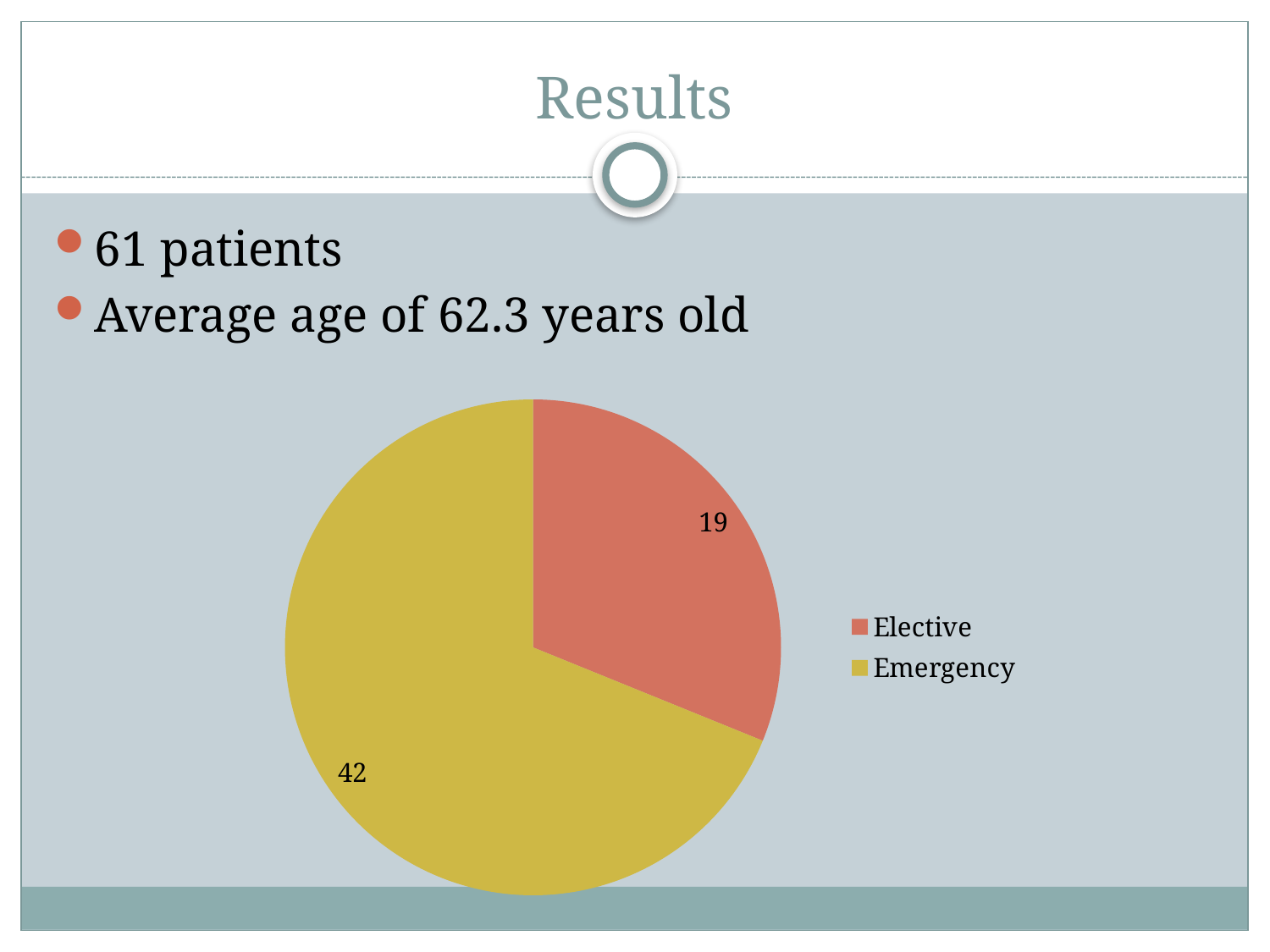
What is the total of the two slices? 61 What kind of chart is shown on the slide? pie chart Which category has the smallest slice? Elective Which category has the largest slice? Emergency How many entries does the legend list? 2 How many slices does the pie chart have? 2 Which colour represents Emergency in the pie chart? yellow What is the difference between the Emergency and Elective values? 23 Which colour represents Elective in the pie chart? red Which is larger, Elective or Emergency? Emergency What is the value for Elective? 19 What is the value for Emergency? 42